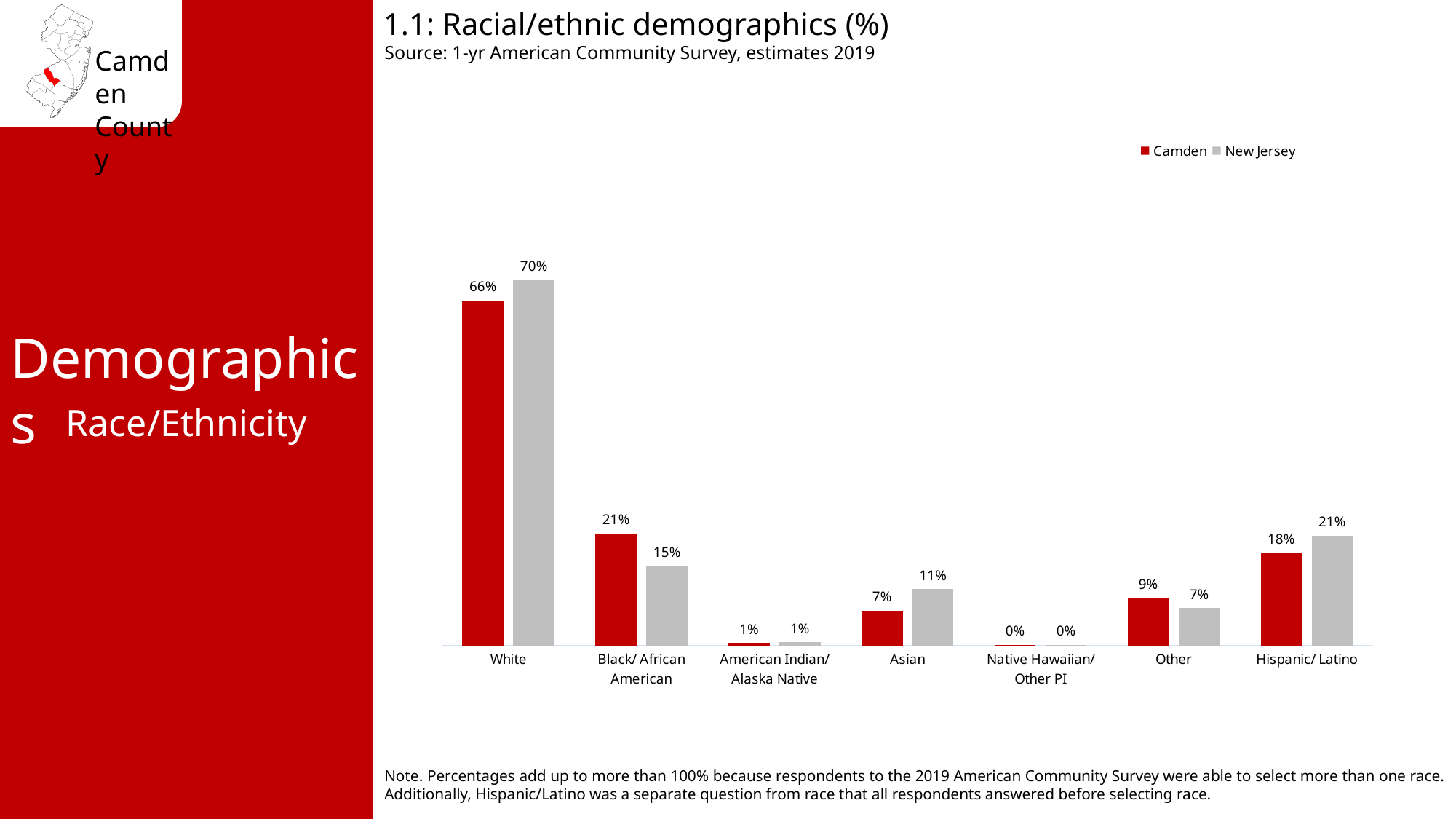
Which is larger for Other: the Camden value or the New Jersey value? Camden Which colour represents the Camden series? Red What is the Camden value for White? 66% What kind of chart is shown? Bar chart How many series does the legend list? 2 What is the difference between the Camden and New Jersey values for Black/ African American? 6% What is the New Jersey value for Asian? 11% How many categories are shown on the x axis? 7 Which category has the lowest New Jersey value? Native Hawaiian/ Other PI What is the Camden value for Hispanic/ Latino? 18% What is the title of the chart? 1.1: Racial/ethnic demographics (%) Which category has the highest Camden value? White